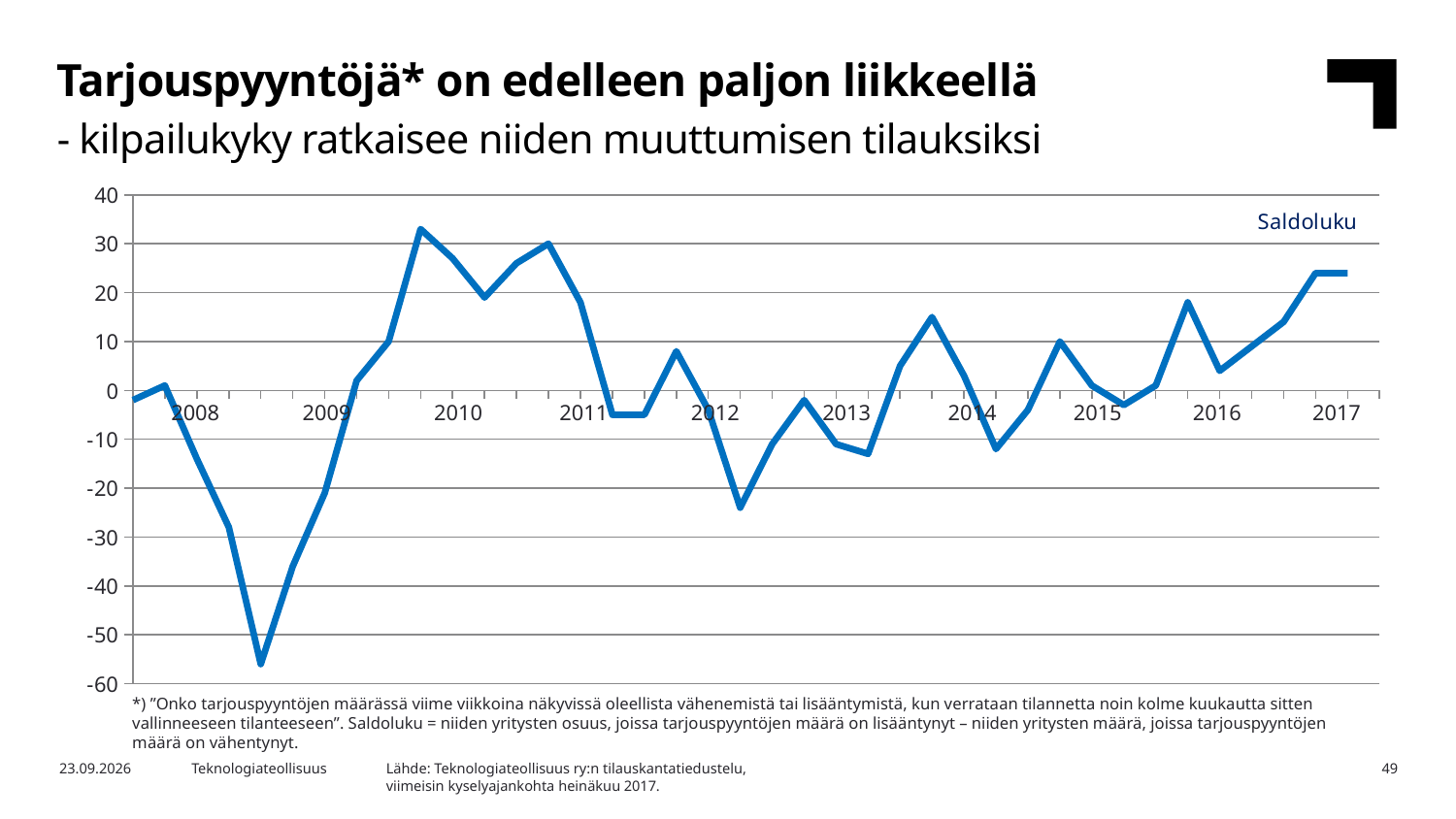
What kind of chart is shown on the slide? line chart Does the Saldoluku line rise or fall between the 2016 tick and the 2017 tick? rise What is the name of the series shown in the chart legend? Saldoluku What is the highest value shown on the y axis of the chart? 40 Is the highest value of the Saldoluku line greater or less than 30? greater Is the lowest point of the Saldoluku line located before or after the 2010 tick on the x axis? before Is the value of the Saldoluku line at the end of the series in 2017 greater or less than 20? greater Is the value of the Saldoluku line at the 2013 tick greater or less than 0? less How many years are labelled on the x axis of the chart? 10 How many series does the chart's legend list? 1